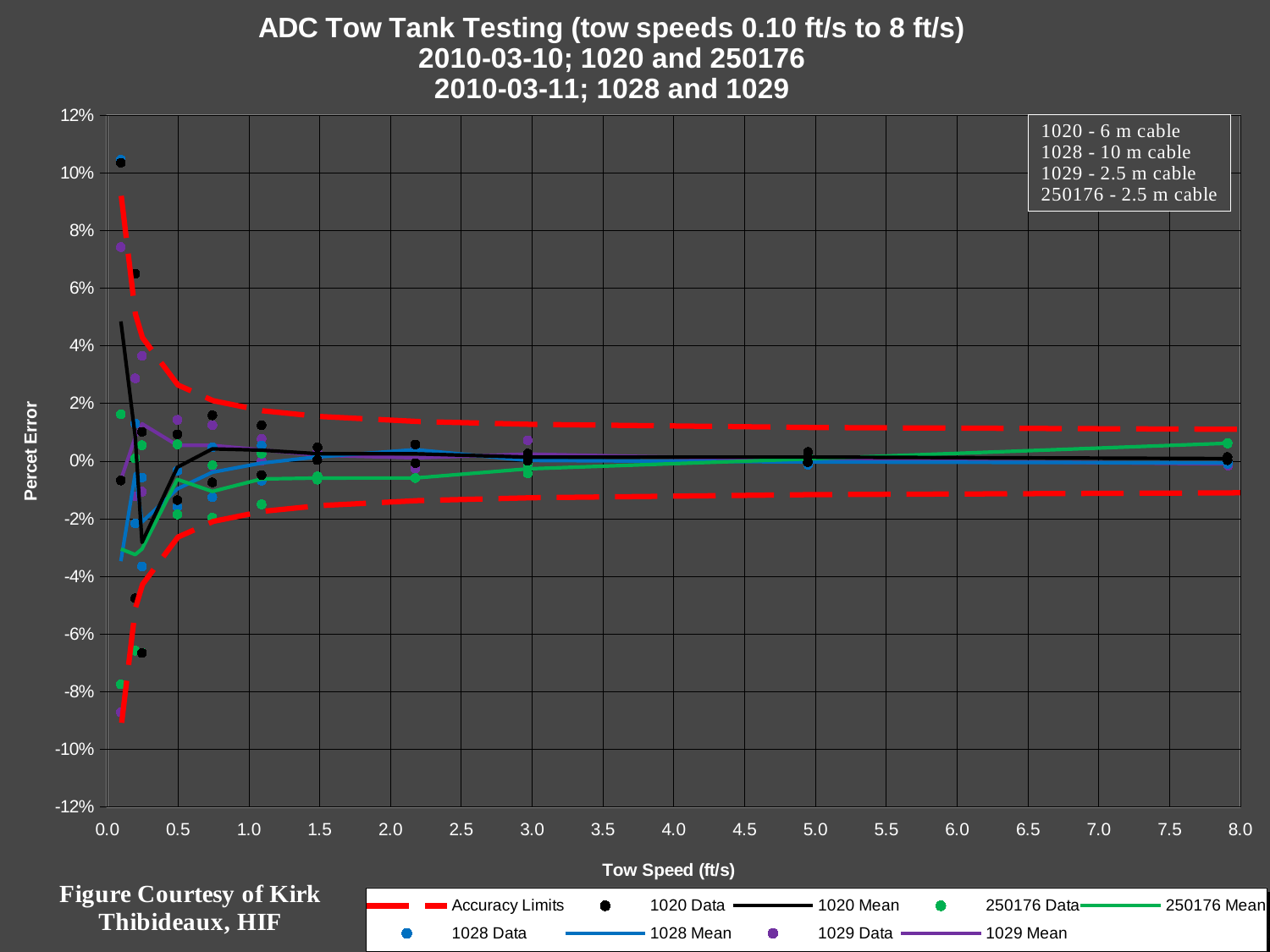
What is the label of the y axis? Percet Error Is the value of the 250176 Mean line at a tow speed of about 0.25 ft/s greater or less than -2%? less What kind of chart is shown on the slide? Line chart with scatter points How many entries does the chart legend list? 9 Is the lower Accuracy Limits line at a tow speed of 8.0 ft/s greater or less than 0%? less Is the value of the 250176 Mean line at a tow speed of about 7.9 ft/s greater or less than 0%? greater What is the label of the x axis? Tow Speed (ft/s) What is the maximum value shown on the y axis? 12% Does the gap between the upper and lower Accuracy Limits lines widen or narrow as tow speed increases? narrow